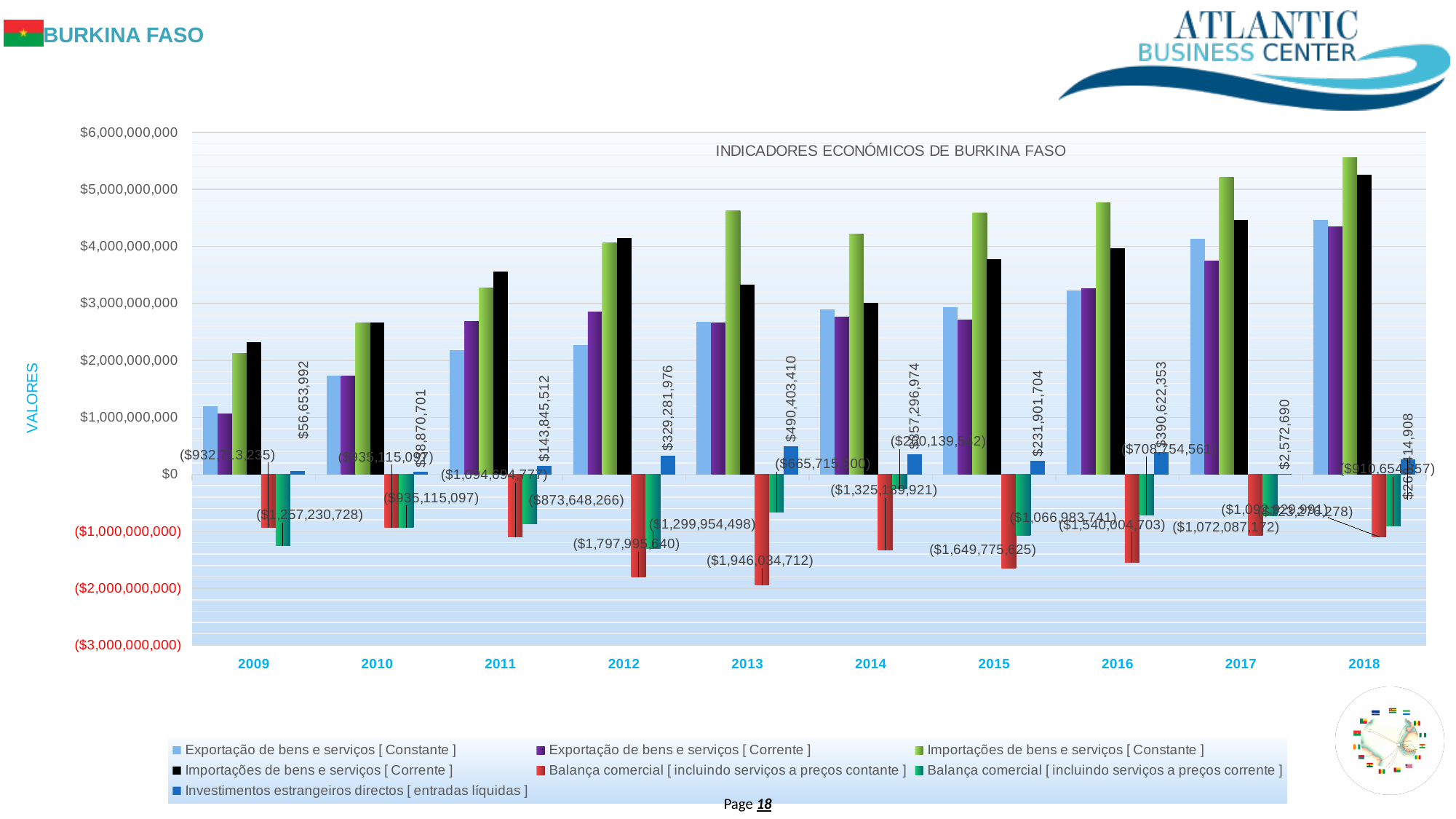
In 2017, which is larger: Exportação de bens e serviços [Constante] or Exportação de bens e serviços [Corrente]? Exportação de bens e serviços [Constante] What is the difference between Investimentos estrangeiros directos in 2013 and in 2012? $161,121,434 What is the value of Balança comercial [incluindo serviços a preços corrente] in 2016? ($708,754,561) How many years are shown on the x axis? 10 What is the value of Investimentos estrangeiros directos [entradas líquidas] in 2013? $490,403,410 What is the value of Investimentos estrangeiros directos [entradas líquidas] in 2009? $56,653,992 What is the title of the chart? INDICADORES ECONÓMICOS DE BURKINA FASO What is the value of Balança comercial [incluindo serviços a preços contante] in 2013? ($1,946,034,712) In which year is Investimentos estrangeiros directos [entradas líquidas] highest? 2013 How many series does the legend list? 7 What type of chart is shown on the slide? Bar chart Is the value of Importações de bens e serviços [Constante] in 2018 greater or less than $5,000,000,000? greater